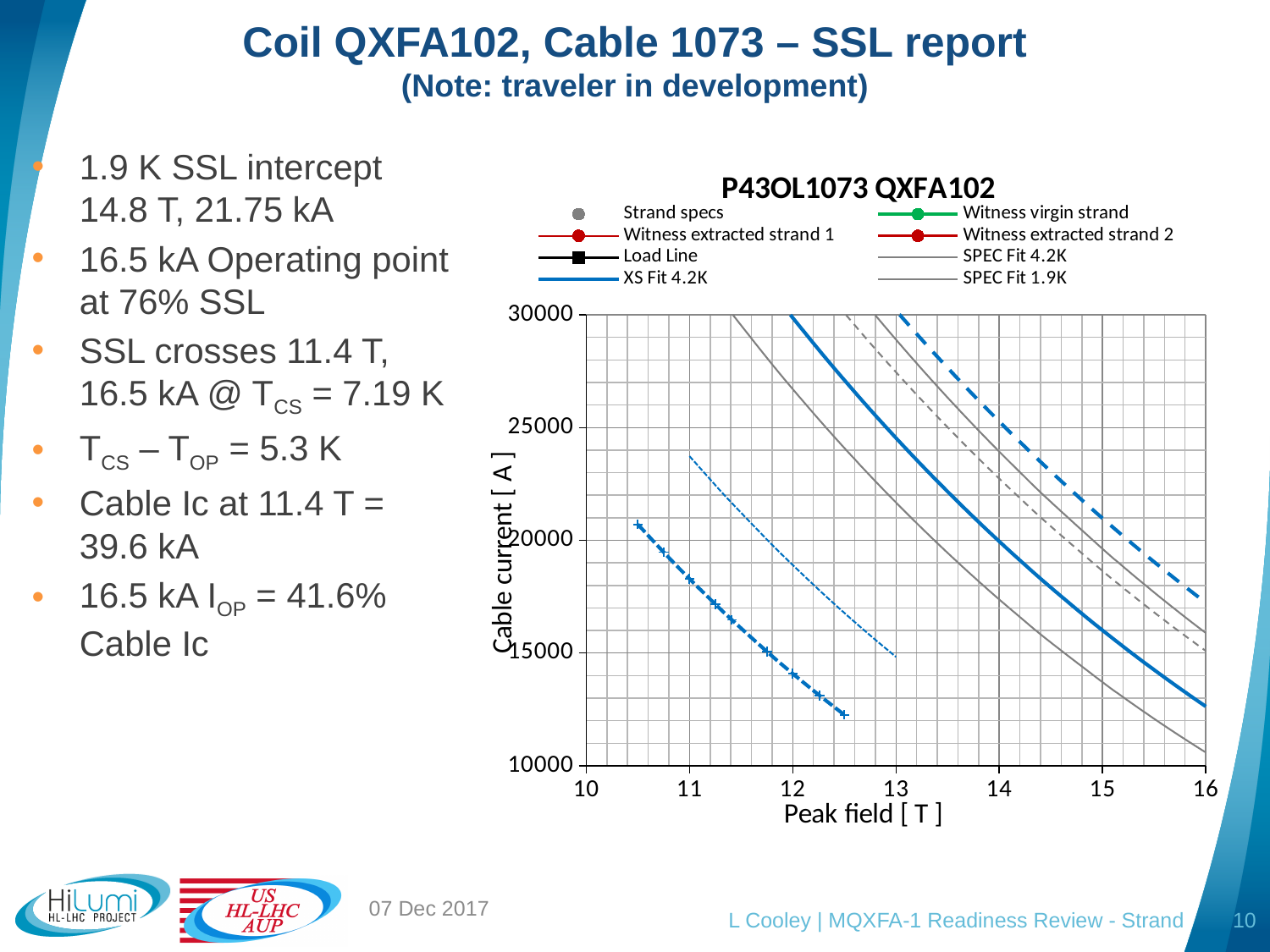
How many series does the chart legend list? 8 Is the cable current of the XS Fit 4.2K curve at 16 T greater or less than 15000 A? less What is the highest value shown on the y axis of the chart? 30000 Is the cable current of the XS Fit 4.2K curve at 14 T greater or less than 15000 A? greater Do the plotted curves rise or fall as the peak field increases along the x axis? fall How many labelled tick values are shown on the x axis of the chart? 7 What is the label of the x axis of the chart? Peak field [ T ] What is the title of the chart? P43OL1073 QXFA102 What kind of chart is shown on the slide? line chart